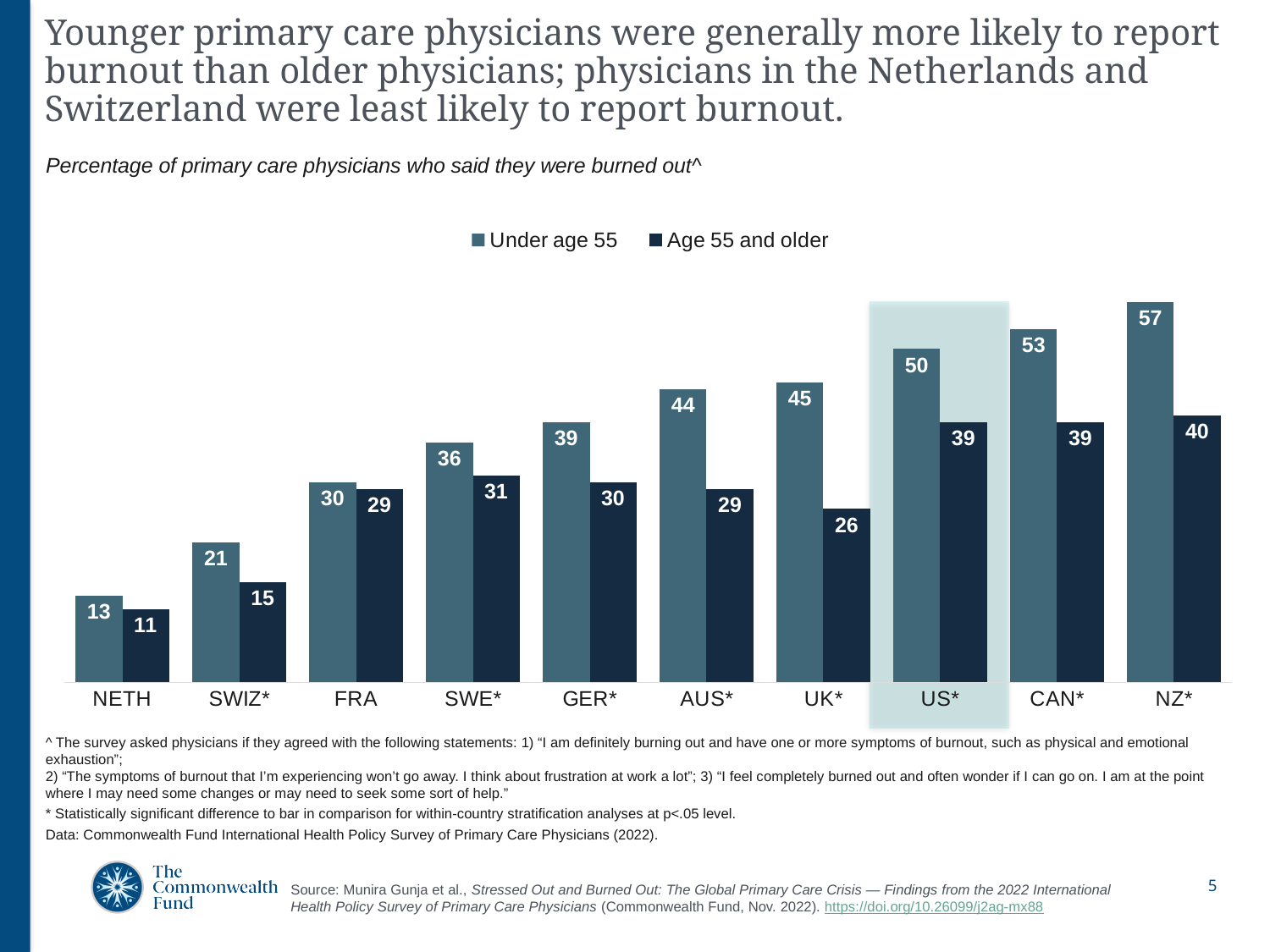
What is the value for physicians age 55 and older in Canada (CAN*)? 39 What kind of chart is shown on the slide? Bar chart Which country has the lowest value for physicians age 55 and older? NETH What is the value for physicians age 55 and older in the Netherlands (NETH)? 11 What percentage of primary care physicians under age 55 in the US reported being burned out? 50 How many series does the legend list? 2 How many countries are shown on the x axis? 10 Which country has the highest value for physicians under age 55? NZ* Which country is highlighted with a shaded background on the chart? US* Do the values for physicians under age 55 generally rise or fall from left to right across the countries? Rise In Sweden (SWE*), which group has the higher value: under age 55 or age 55 and older? Under age 55 What is the difference between the under age 55 and age 55 and older values for the UK? 19